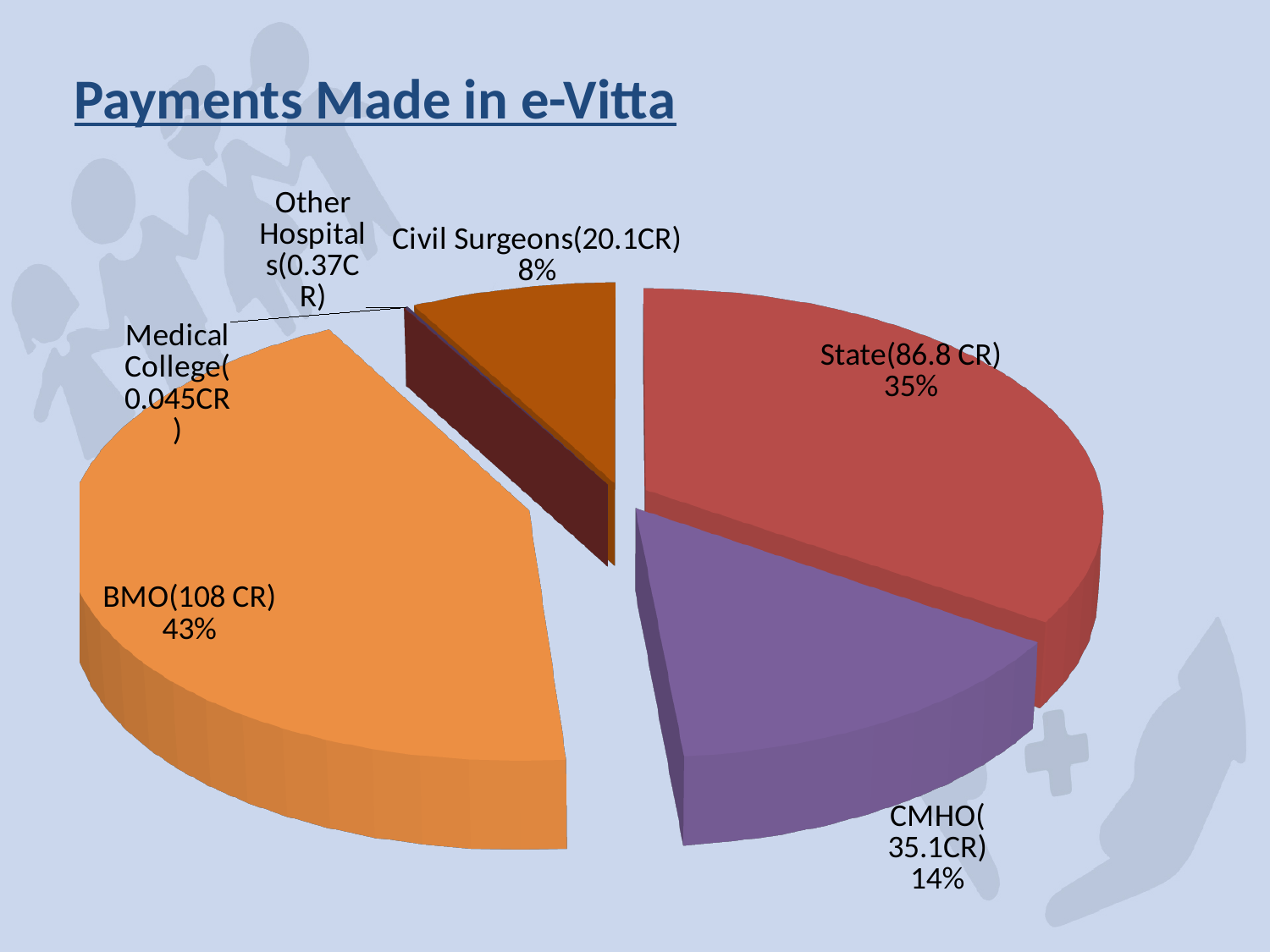
What payment amount is shown for BMO? 108 CR Which category has the smallest payment amount? Medical College How many categories are labelled on the pie chart? 6 What payment amount is shown for Other Hospitals? 0.37CR What is the title of the chart? Payments Made in e-Vitta What share of the pie does the State slice represent? 35% What kind of chart is shown on the slide? pie chart What share of the pie does the BMO slice represent? 43% What share of the pie does the CMHO slice represent? 14% Which is larger, the share for State or the share for CMHO? State Which category has the largest share of the pie? BMO